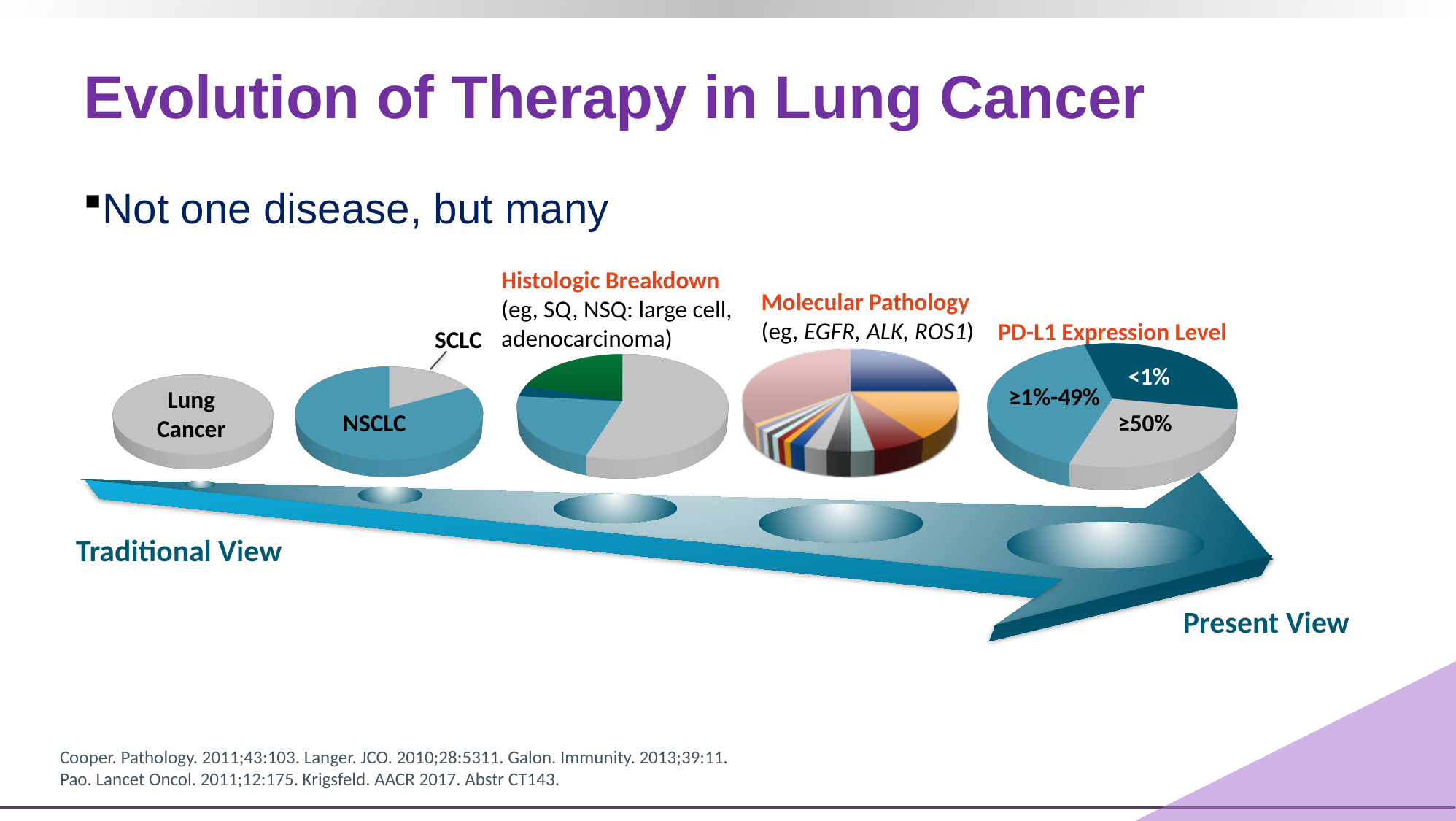
What label is shown on the leftmost pie chart? Lung Cancer How many slices does the pie chart labelled NSCLC and SCLC have? 2 What is the title of the rightmost pie chart on the slide? PD-L1 Expression Level How many slices does the PD-L1 Expression Level pie chart have? 3 In the pie chart labelled NSCLC and SCLC, which category has the smallest slice? SCLC In the PD-L1 Expression Level pie chart, which slice is larger: "<1%" or "≥1%-49%"? ≥1%-49% In the second pie chart from the left, which slice is larger: NSCLC or SCLC? NSCLC How many pie charts are shown along the arrow on the slide? 5 What kind of chart is used to show the PD-L1 Expression Level breakdown? pie chart